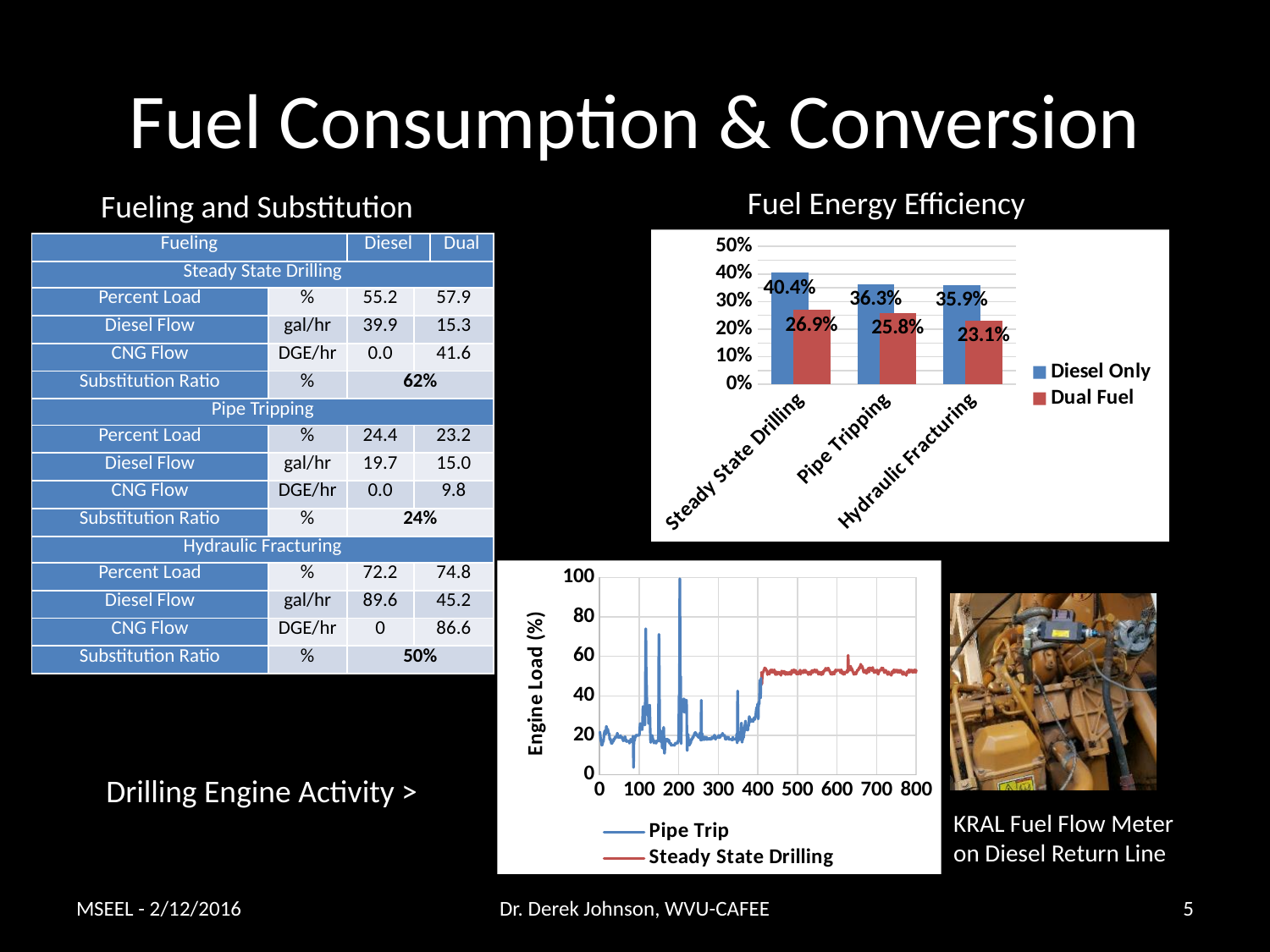
In the Drilling Engine Activity line chart, is the highest value of the Pipe Trip series greater or less than 80? greater In the Fuel Energy Efficiency chart, which is larger for Pipe Tripping: the Diesel Only value or the Dual Fuel value? Diesel Only What kind of chart is the Fuel Energy Efficiency chart? Bar chart In the Fuel Energy Efficiency chart, how many categories are shown on the x axis? 3 In the Fuel Energy Efficiency chart, which category has the highest Diesel Only value? Steady State Drilling In the Fuel Energy Efficiency chart, what is the Dual Fuel value for Hydraulic Fracturing? 23.1% In the Drilling Engine Activity line chart, what is the label of the y axis? Engine Load (%) In the Fuel Energy Efficiency chart, what is the Dual Fuel value for Pipe Tripping? 25.8% In the Fuel Energy Efficiency chart, what is the Diesel Only value for Steady State Drilling? 40.4% In the Fuel Energy Efficiency chart, how many series does the legend list? 2 In the Fuel Energy Efficiency chart, which category has the lowest Dual Fuel value? Hydraulic Fracturing In the Fuel Energy Efficiency chart, what is the difference between the Diesel Only and Dual Fuel values for Steady State Drilling? 13.5%